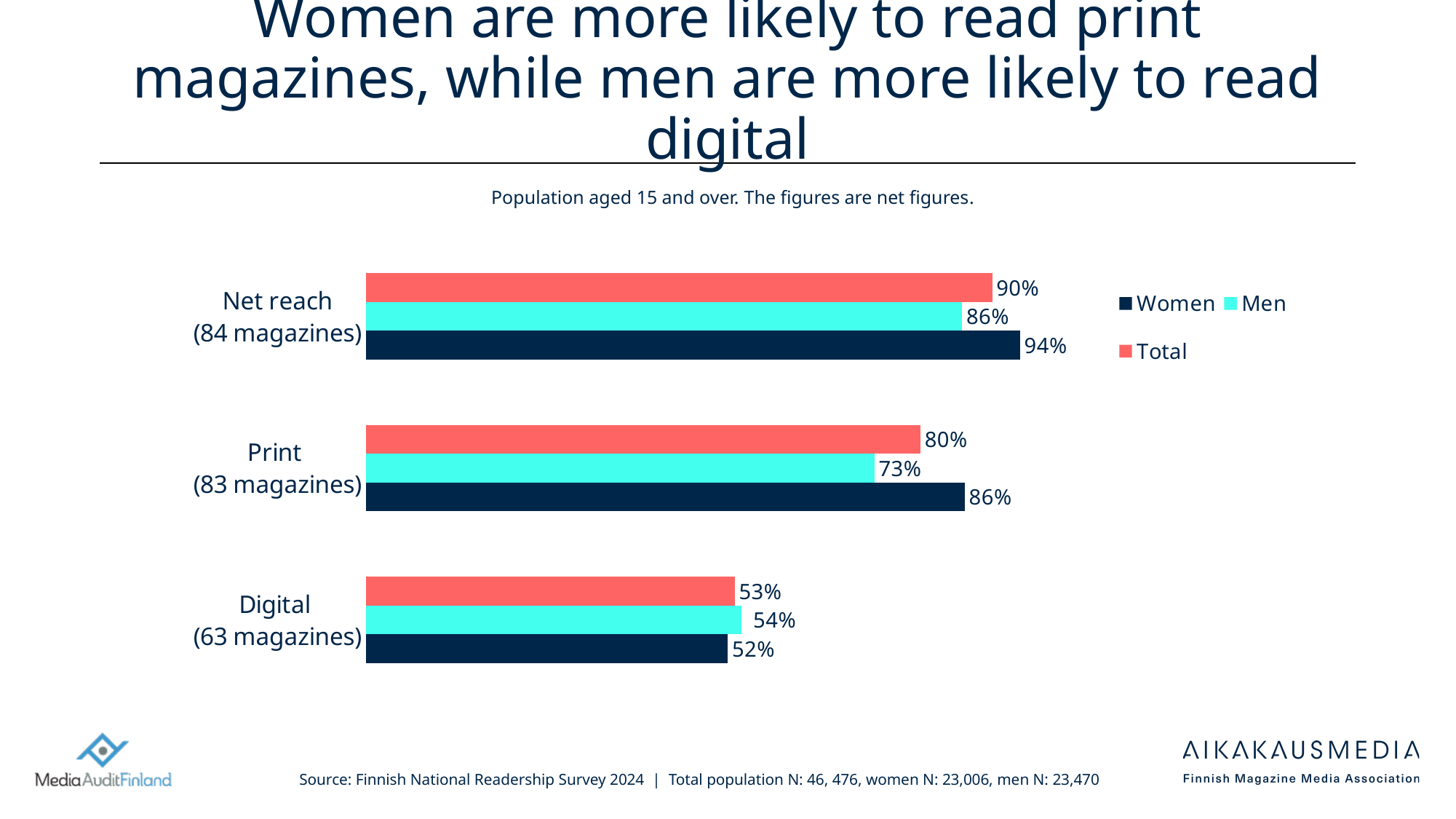
What is the value for Men for Print (83 magazines)? 73% Which category has the lowest Total value? Digital (63 magazines) What is the value for Men for Digital (63 magazines)? 54% What is the Total value for Digital (63 magazines)? 53% What kind of chart is shown on the slide? Bar chart Which colour represents the Men series in the chart? Light turquoise Which category has the highest value for Women? Net reach (84 magazines) What is the value for Women for Net reach (84 magazines)? 94% How many series does the legend list? 3 How many categories are shown on the chart? 3 What is the difference between the Women and Men values for Print (83 magazines)? 13% Which is larger for Net reach (84 magazines): the Women value or the Men value? Women